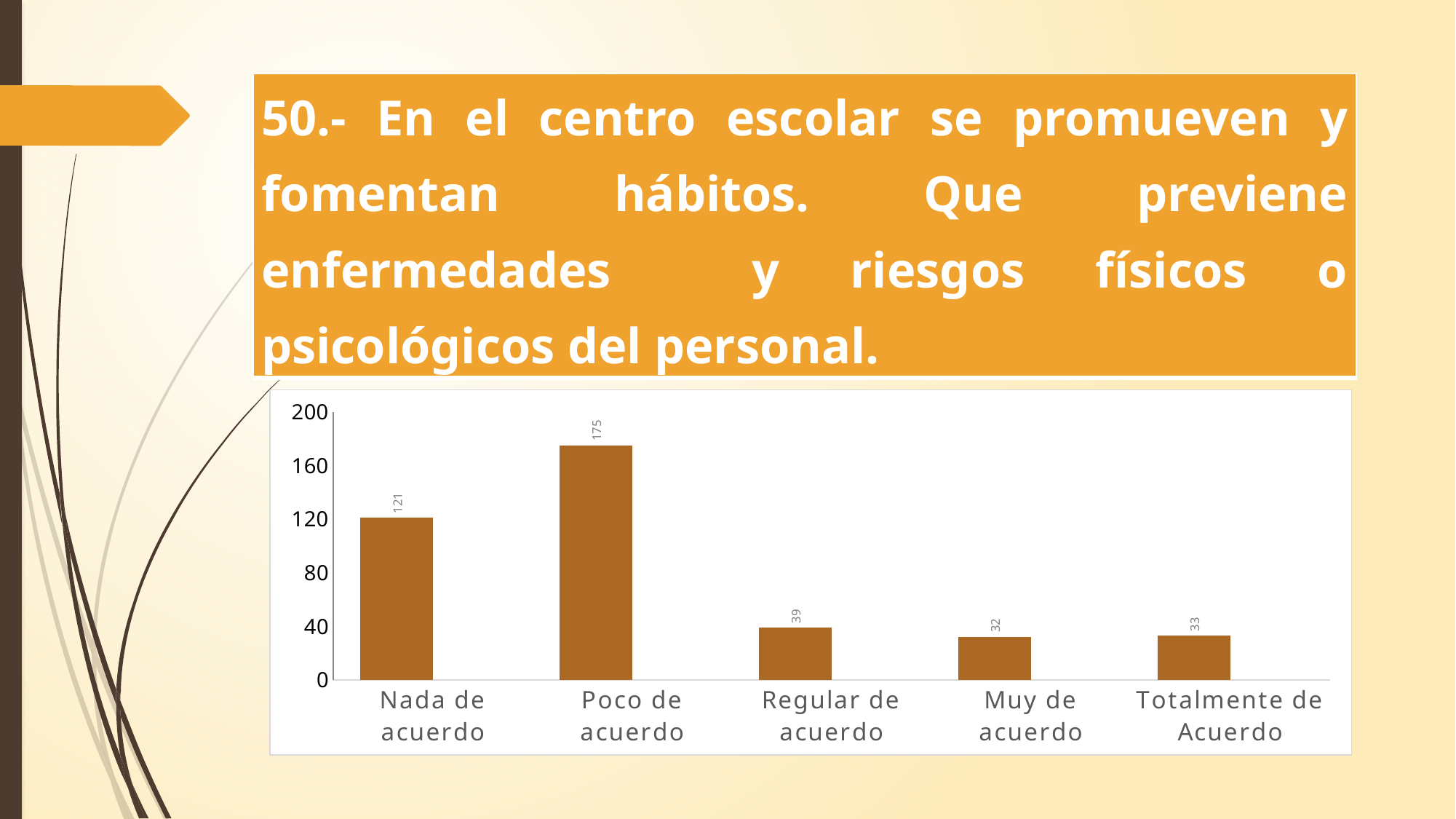
How many categories are shown on the x axis? 5 What is the highest value shown on the vertical axis? 200 What is the value for "Totalmente de Acuerdo"? 33 What is the value for "Poco de acuerdo"? 175 What is the difference between the values for "Poco de acuerdo" and "Nada de acuerdo"? 54 What kind of chart is shown on the slide? bar chart Which category has the highest value? Poco de acuerdo Which is larger, the value for "Regular de acuerdo" or the value for "Muy de acuerdo"? Regular de acuerdo Is the value for "Nada de acuerdo" greater or less than 80? greater Which category has the lowest value? Muy de acuerdo What is the value for "Nada de acuerdo"? 121 What is the value for "Regular de acuerdo"? 39